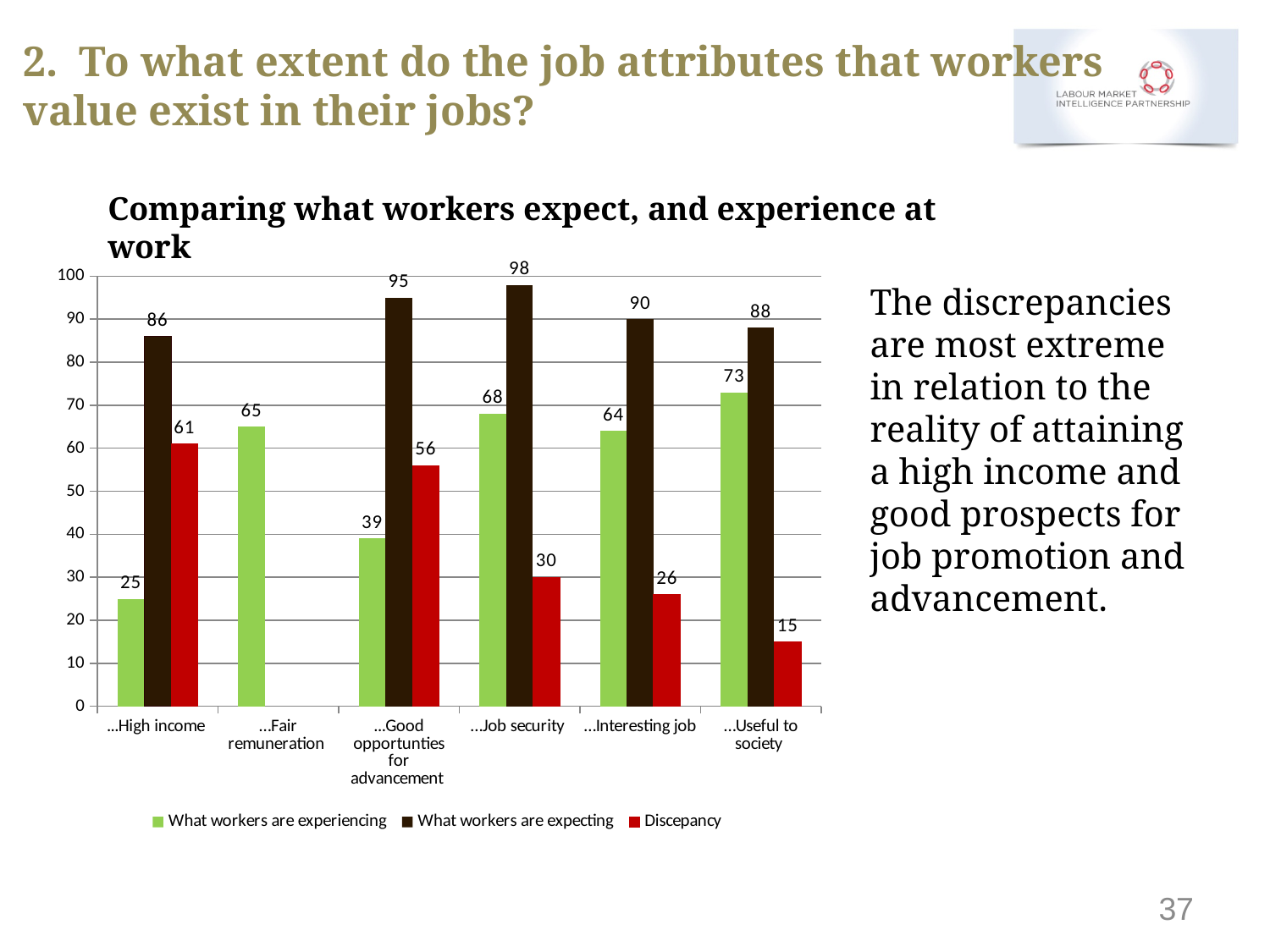
What is the value of 'What workers are experiencing' for Fair remuneration? 65 What is the Discrepancy value for Useful to society? 15 What is the value of 'What workers are expecting' for Job security? 98 Which category has the lowest value for 'What workers are experiencing'? High income What kind of chart is shown on the slide? Bar chart Which is larger: the Discrepancy for High income or the Discrepancy for Job security? High income How many categories are shown on the x axis? 6 How many series does the legend list? 3 What is the difference between 'What workers are expecting' and 'What workers are experiencing' for Good opportunities for advancement? 56 Is the value of 'What workers are experiencing' for Useful to society greater or less than 70? greater Which category has the highest value for 'What workers are expecting'? Job security What is the value of 'What workers are experiencing' for High income? 25